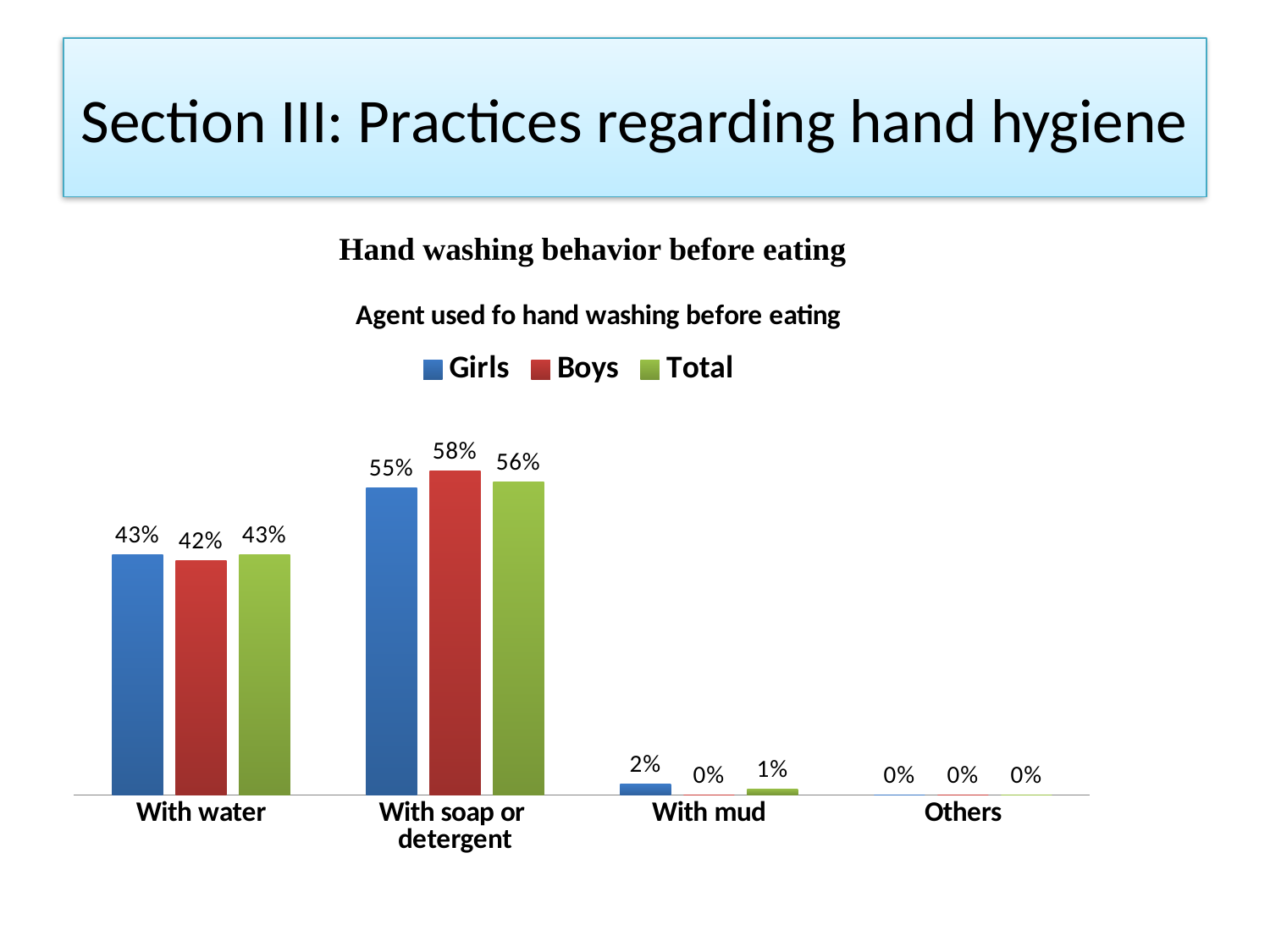
Which category has the lowest Total value? Others How many categories are shown on the x axis? 4 Which is larger for 'With water': the Girls value or the Boys value? Girls What is the value for Girls in the 'With soap or detergent' category? 55% What is the value for Boys in the 'With water' category? 42% What is the chart's title? Agent used fo hand washing before eating Which colour represents the Total series in the legend? Green What is the Total value for 'With mud'? 1% What kind of chart is shown on the slide? Bar chart How many series does the legend list? 3 Which category has the highest value for Boys? With soap or detergent What is the difference between the Boys and Girls values for 'With soap or detergent'? 3%